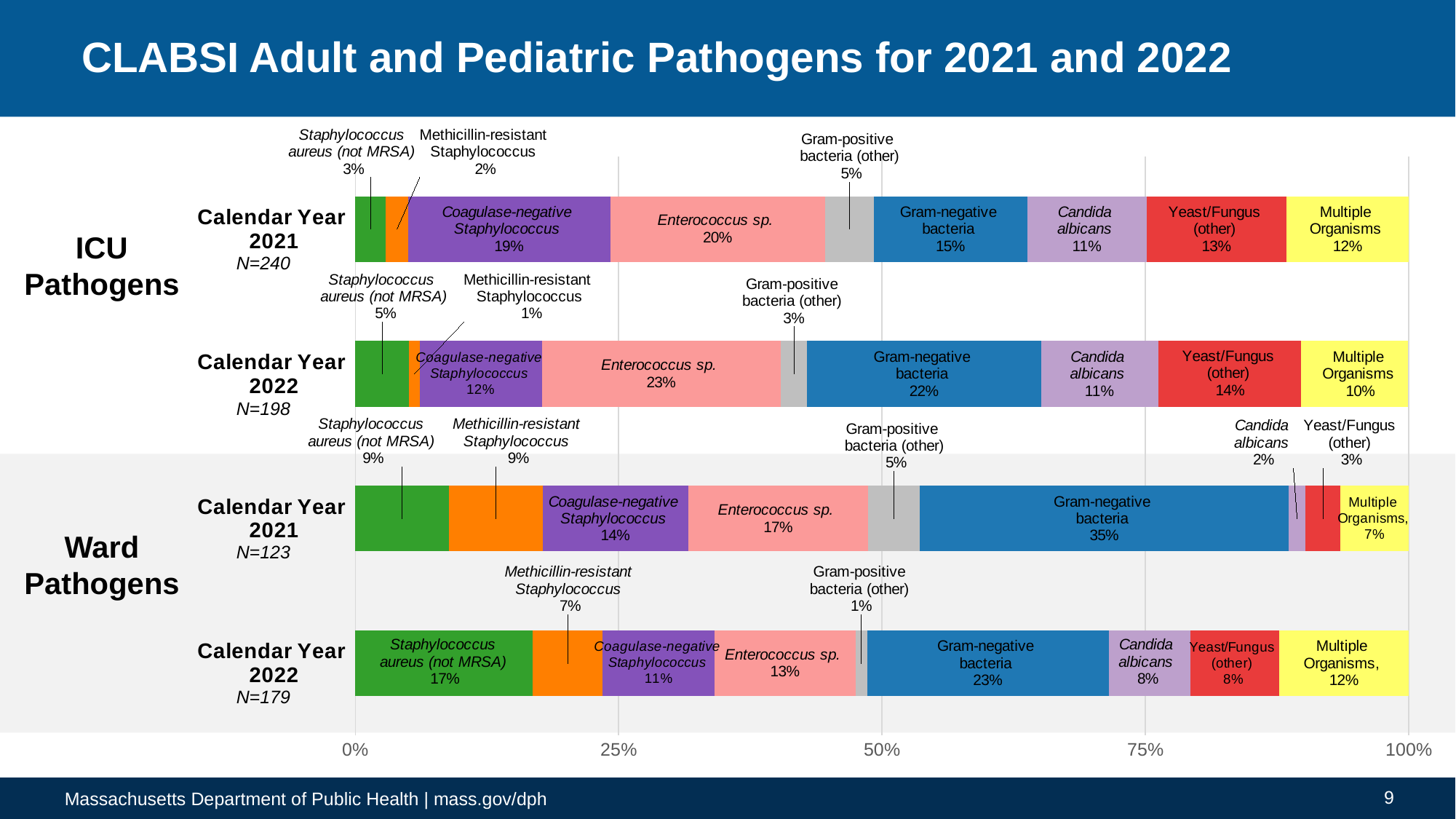
By how many percentage points did the Gram-negative bacteria share of ICU Pathogens change from Calendar Year 2021 to Calendar Year 2022? 7 percentage points What percentage of ICU Pathogens in Calendar Year 2022 were Enterococcus sp.? 23% Which pathogen category has the smallest share in the ICU Pathogens Calendar Year 2022 bar? Methicillin-resistant Staphylococcus What type of chart is shown on the slide? Stacked bar chart What percentage of Ward Pathogens in Calendar Year 2021 were Candida albicans? 2% What percentage of Ward Pathogens in Calendar Year 2021 were Gram-negative bacteria? 35% How many bars are shown in the chart? 4 What is the N value for Ward Pathogens in Calendar Year 2022? N=179 Did the share of Staphylococcus aureus (not MRSA) among Ward Pathogens rise or fall from Calendar Year 2021 to Calendar Year 2022? Rise Which pathogen category has the largest share in the Ward Pathogens Calendar Year 2021 bar? Gram-negative bacteria What percentage of Ward Pathogens in Calendar Year 2022 were Multiple Organisms? 12% Which is larger: the Enterococcus sp. share for ICU Pathogens in 2021 or for Ward Pathogens in 2022? ICU Pathogens in 2021